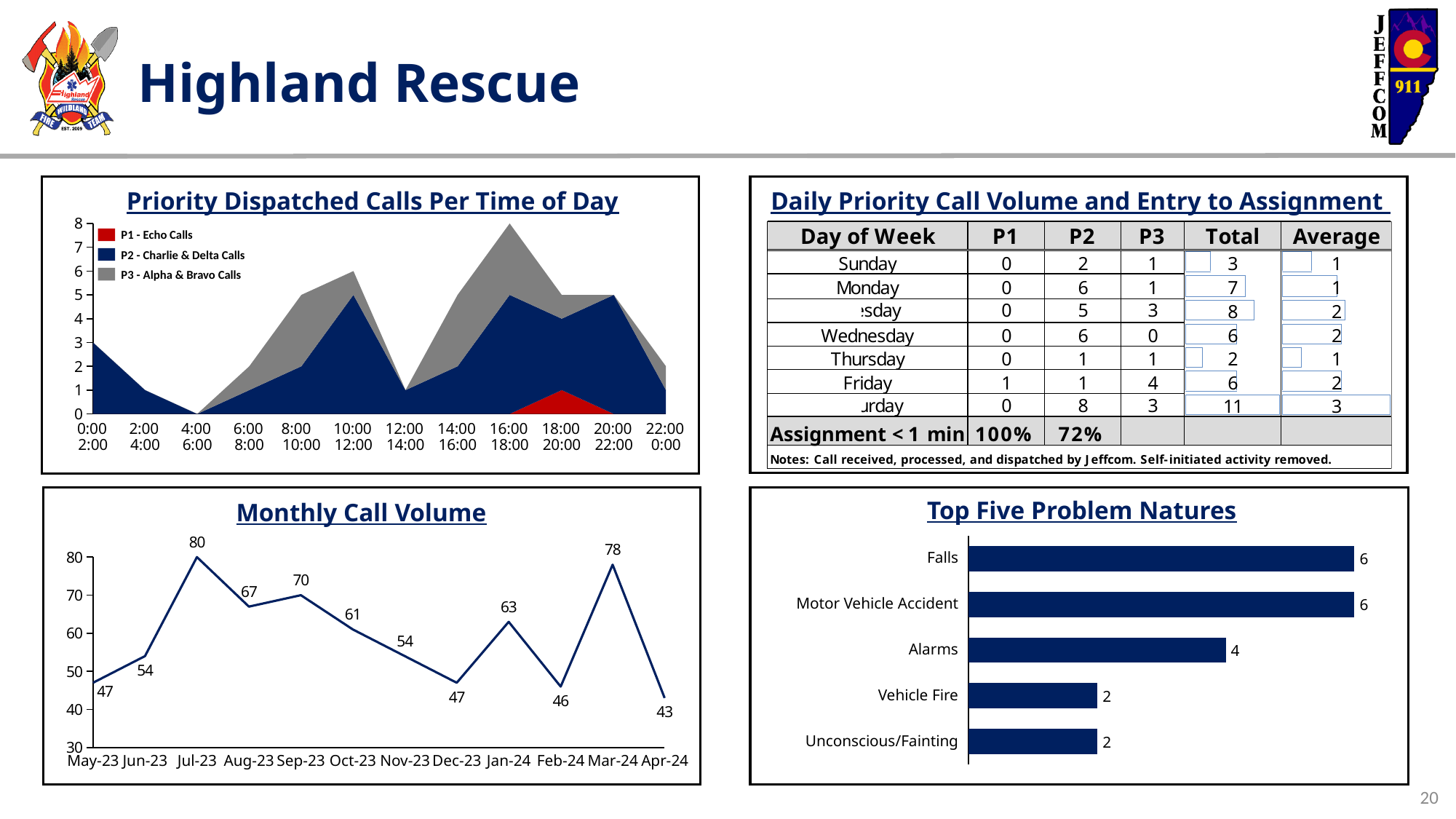
In the Monthly Call Volume chart, which is larger, the value for Sep-23 or the value for Oct-23? Sep-23 How many months are plotted in the Monthly Call Volume chart? 12 In the Top Five Problem Natures chart, what is the value for Alarms? 4 How many series does the legend of the Priority Dispatched Calls Per Time of Day chart list? 3 In the Monthly Call Volume chart, what is the value for Mar-24? 78 In the Priority Dispatched Calls Per Time of Day chart, is the total stacked value at 16:00-18:00 greater or less than 6? greater In the Monthly Call Volume chart, which month has the highest call volume? Jul-23 In the Monthly Call Volume chart, what is the value for Jul-23? 80 In the Top Five Problem Natures chart, what is the difference between the values for Falls and Alarms? 2 In the Monthly Call Volume chart, which month has the lowest call volume? Apr-24 In the Monthly Call Volume chart, what is the difference between the values for Jul-23 and Aug-23? 13 What kind of chart is the Top Five Problem Natures chart? bar chart